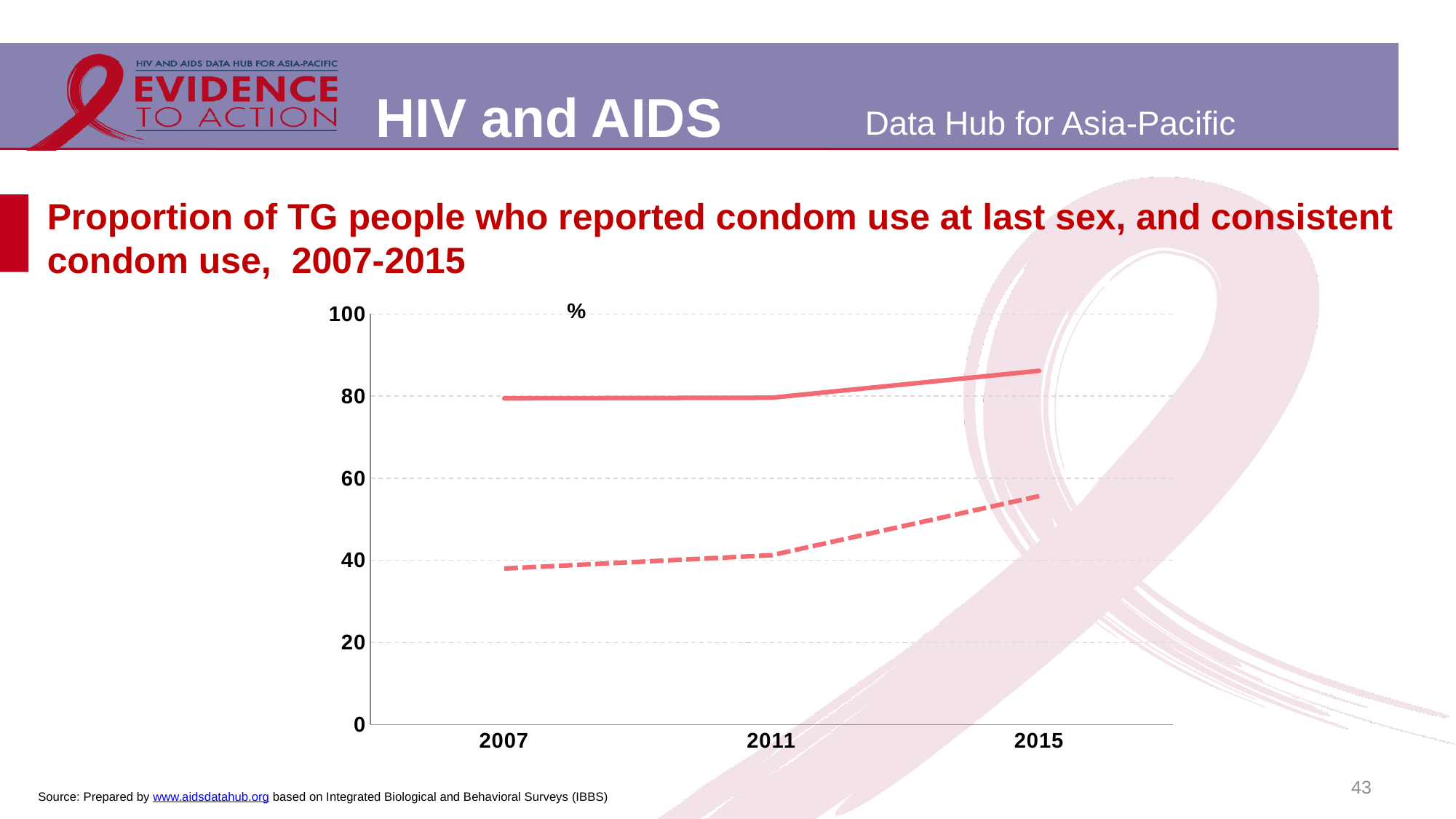
In which year does the dashed line reach its highest value? 2015 Does the dashed line rise or fall from 2007 to 2015? rise In 2015, which line has the higher value, the solid line or the dashed line? the solid line Is the value of the dashed line in 2007 greater or less than 40? less Is the value of the solid line in 2015 greater or less than 80? greater What kind of chart is shown on the slide? line chart Is the value of the dashed line in 2015 greater or less than 60? less How many years are marked on the x axis of the chart? 3 Does the solid line rise or fall from 2011 to 2015? rise What unit is shown at the top of the y axis? % How many lines are plotted on the chart? 2